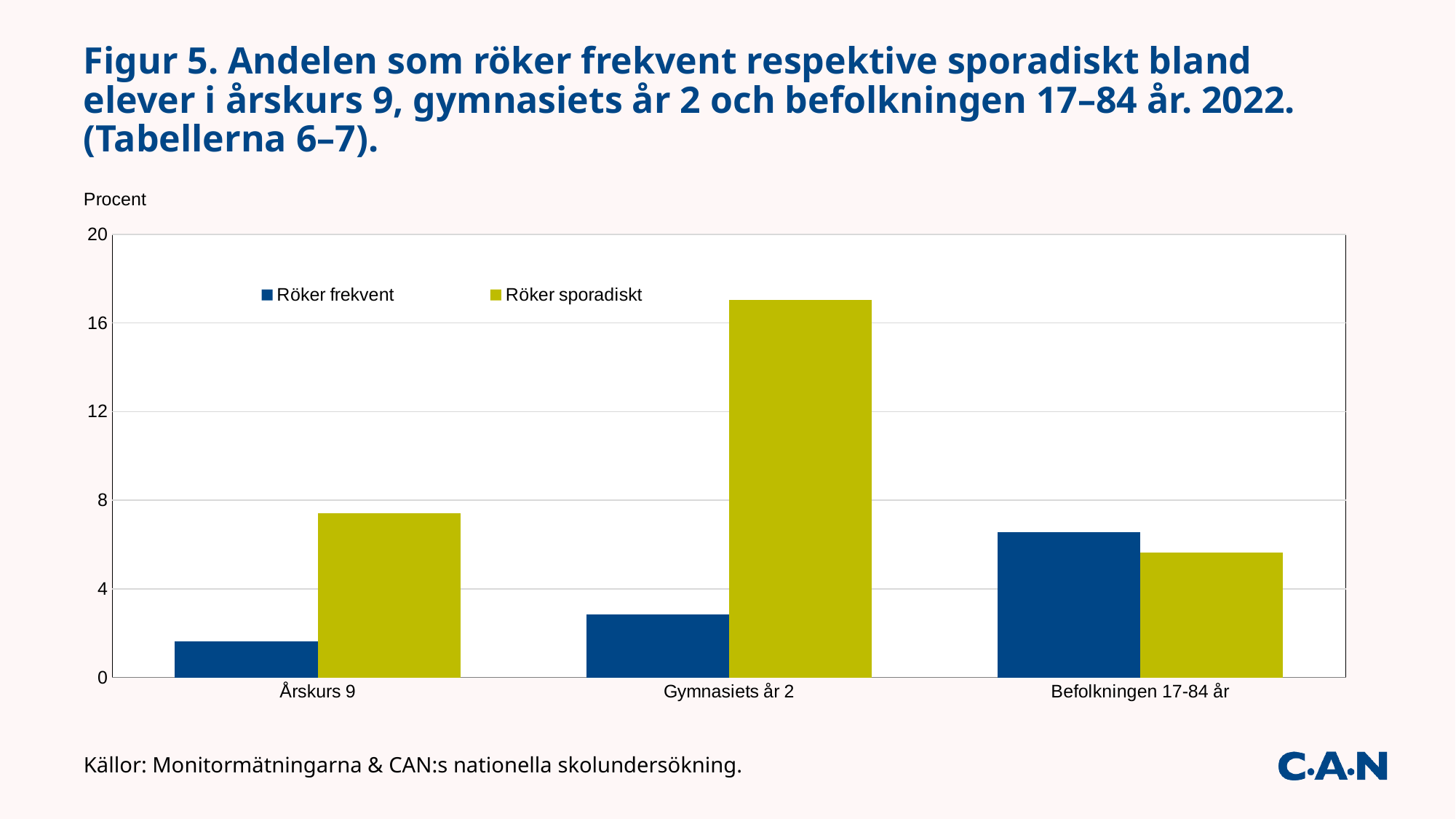
Is the value for Röker frekvent in Befolkningen 17-84 år greater or less than 4? greater How many categories are shown on the x axis? 3 Is the value for Röker sporadiskt in Årskurs 9 greater or less than 8? less Which category has the lowest value for Röker sporadiskt? Befolkningen 17-84 år For Befolkningen 17-84 år, which is larger: Röker frekvent or Röker sporadiskt? Röker frekvent Is the value for Röker sporadiskt in Gymnasiets år 2 greater or less than 16? greater Which category has the highest value for Röker frekvent? Befolkningen 17-84 år What kind of chart is shown on the slide? bar chart How many series does the legend list? 2 Which category has the lowest value for Röker frekvent? Årskurs 9 What unit is shown on the y axis label? Procent Which category has the highest value for Röker sporadiskt? Gymnasiets år 2